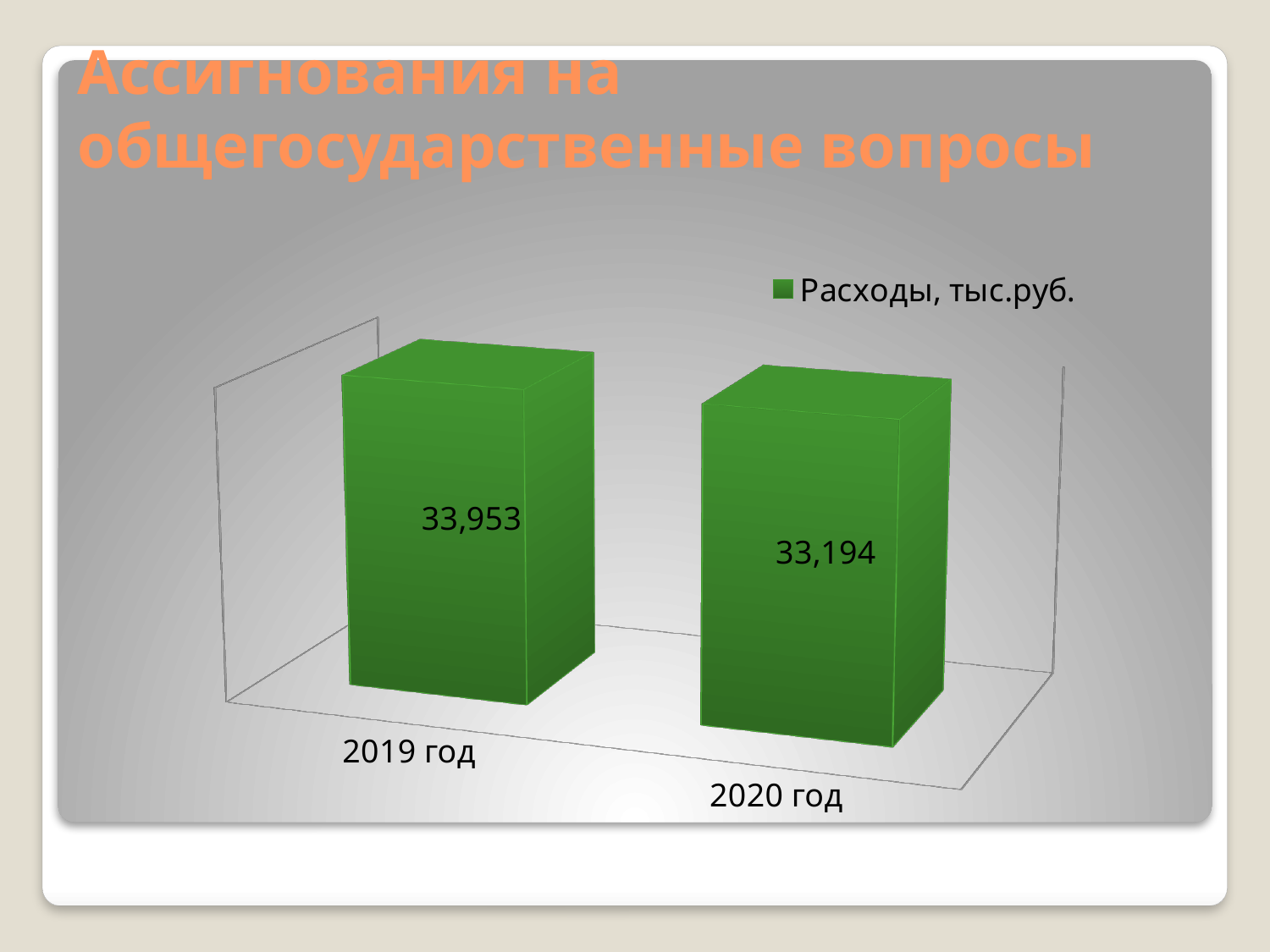
What is the title of the slide? Ассигнования на общегосударственные вопросы What is the difference between the values for 2019 год and 2020 год? 759 What is the series name shown in the legend? Расходы, тыс.руб. What is the value for 2020 год? 33,194 Which is larger, the value for 2019 год or the value for 2020 год? 2019 год What is the value for 2019 год? 33,953 Which year has the lowest value? 2020 год What kind of chart is shown on the slide? bar chart How many categories are shown in the chart? 2 How many series does the legend list? 1 Do the values rise or fall from 2019 год to 2020 год? fall Which year has the highest value? 2019 год